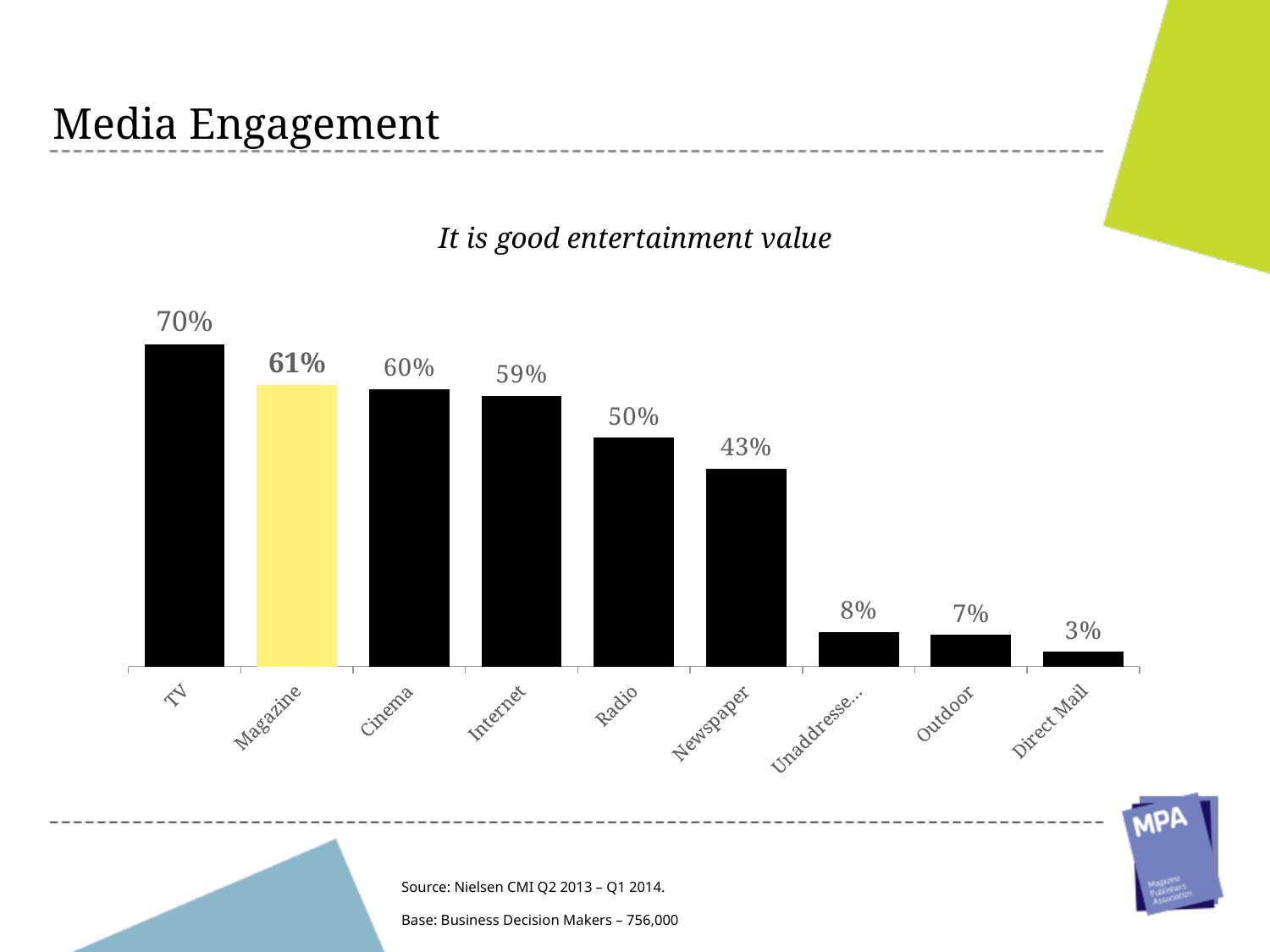
What is the value for Direct Mail? 3% What is the value for TV? 70% What is the value for Radio? 50% What is the value for Magazine? 61% What is the difference between the values for Radio and Newspaper? 7% What kind of chart is shown on the slide? Bar chart What is the difference between the values for TV and Magazine? 9% Which category has the lowest value? Direct Mail Which bar is highlighted in yellow? Magazine How many categories are shown in the chart? 9 Which category has the highest value? TV Which is larger, the value for Cinema or the value for Internet? Cinema